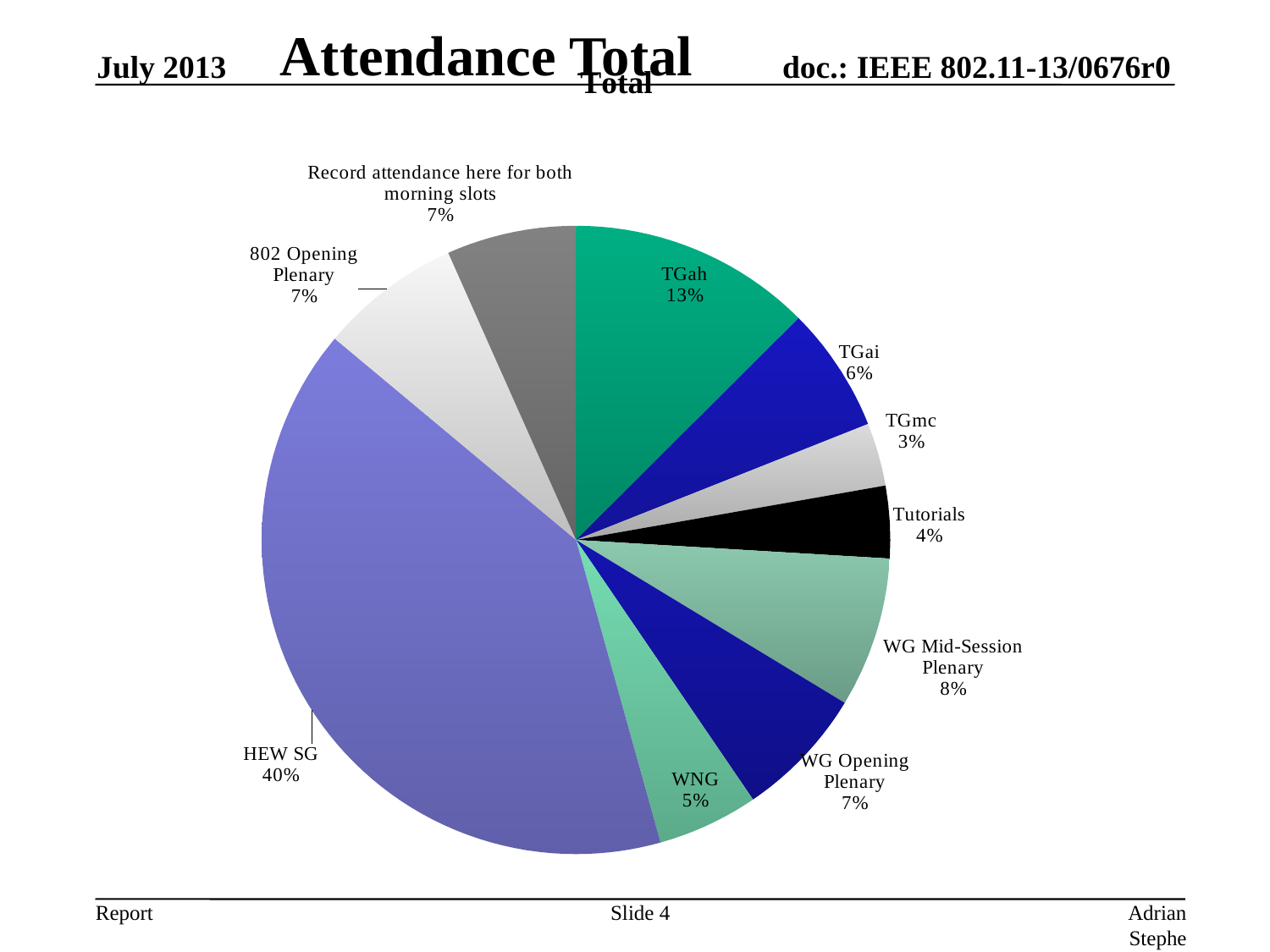
Which slice of the pie is the largest? HEW SG Which slice of the pie is the smallest? TGmc How many slices does the pie chart have? 10 What is the value shown for TGmc? 3% What is the value shown for TGah? 13% Which is larger, the share for WNG or the share for Tutorials? WNG What is the difference between the TGah share and the TGai share? 7% What is the value shown for WG Mid-Session Plenary? 8% What kind of chart is shown on the slide? pie chart What is the difference between the HEW SG share and the WG Opening Plenary share? 33% What share of the pie does HEW SG account for? 40% What is the value shown for the slice labelled 'Record attendance here for both morning slots'? 7%